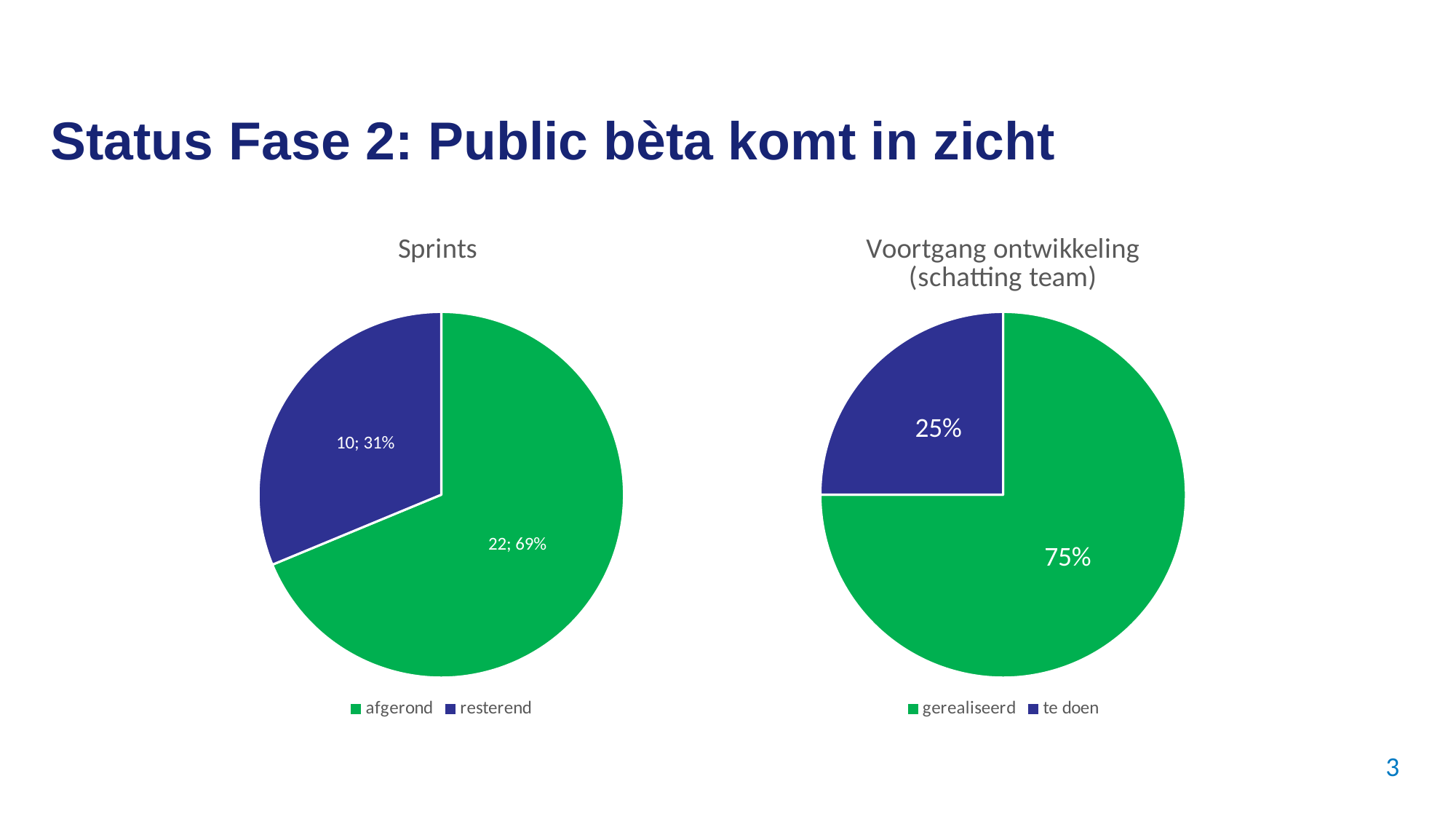
In the 'Sprints' chart, how many sprints are 'afgerond'? 22 How many entries does the legend of the 'Voortgang ontwikkeling (schatting team)' chart list? 2 In the 'Sprints' chart, what share of the pie is 'resterend'? 31% In the 'Sprints' chart, what is the difference between the 'afgerond' and 'resterend' counts? 12 In the 'Voortgang ontwikkeling (schatting team)' chart, what share is 'gerealiseerd'? 75% In the 'Voortgang ontwikkeling (schatting team)' chart, which slice is the smallest? te doen What kind of chart is the 'Sprints' chart? Pie chart In the 'Sprints' chart, how many sprints are 'resterend'? 10 In the 'Sprints' chart, what is the total number of sprints across both slices? 32 In the 'Sprints' chart, what share of the pie is 'afgerond'? 69% In the 'Sprints' chart, which slice is larger, 'afgerond' or 'resterend'? afgerond